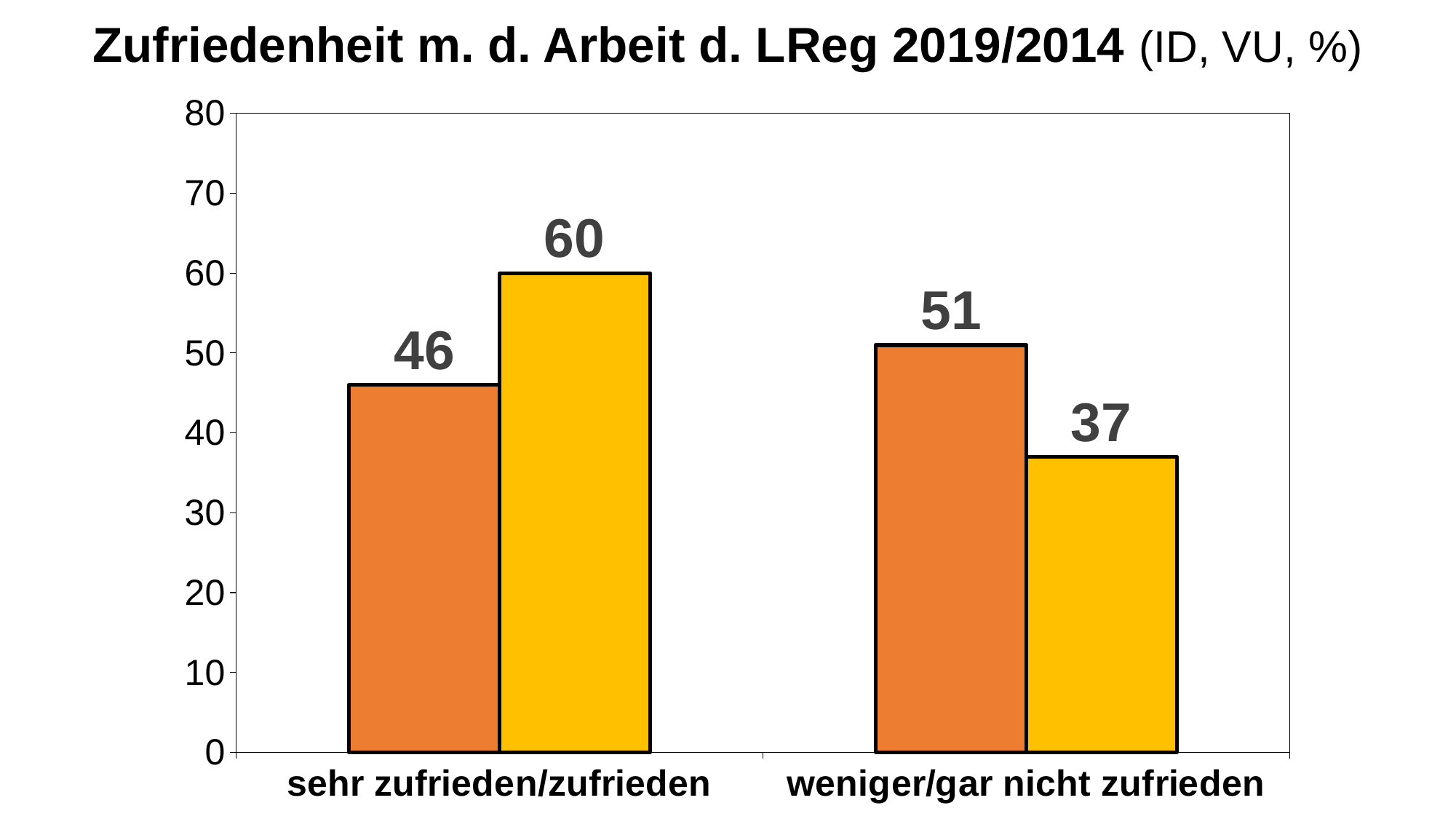
What is the value of the yellow bar for "sehr zufrieden/zufrieden"? 60 For "weniger/gar nicht zufrieden", which bar is larger, the orange or the yellow one? The orange bar What is the value of the orange bar for "weniger/gar nicht zufrieden"? 51 What is the value of the yellow bar for "weniger/gar nicht zufrieden"? 37 Is the value of the orange bar for "sehr zufrieden/zufrieden" greater or less than 50? less How many categories are shown on the x axis? 2 What is the value of the orange bar for "sehr zufrieden/zufrieden"? 46 Which bar has the highest value in the chart? The yellow bar for sehr zufrieden/zufrieden (60) Which bar has the lowest value in the chart? The yellow bar for weniger/gar nicht zufrieden (37) What is the difference between the yellow and orange bars for "sehr zufrieden/zufrieden"? 14 What is the difference between the orange and yellow bars for "weniger/gar nicht zufrieden"? 14 What type of chart is shown on the slide? Bar chart